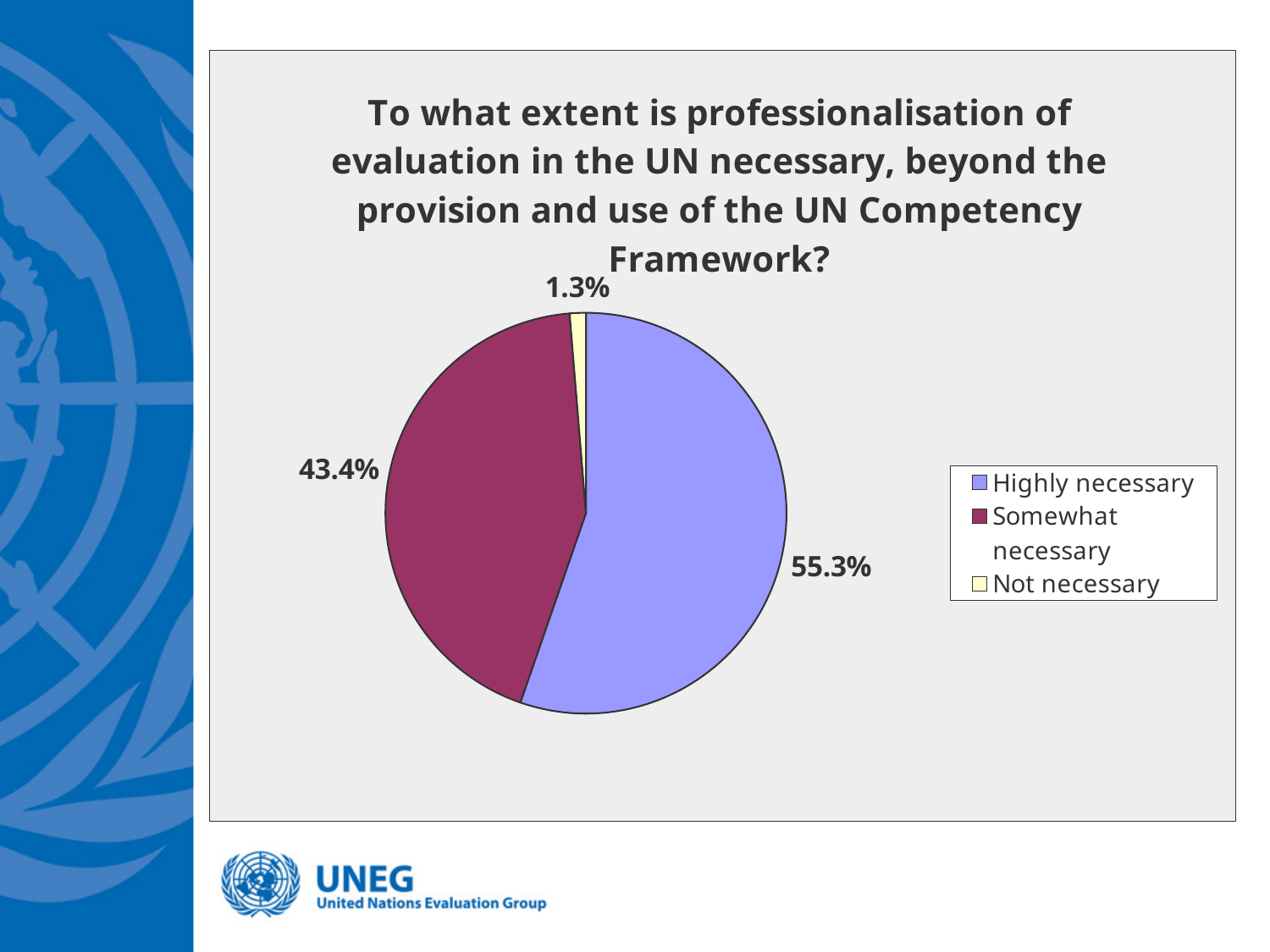
What percentage of respondents said professionalisation of evaluation is not necessary? 1.3% What is the combined share of the 'Highly necessary' and 'Somewhat necessary' slices? 98.7% Which response category has the largest share of the pie? Highly necessary What colour is the 'Somewhat necessary' slice? dark magenta What percentage of respondents said professionalisation of evaluation is highly necessary? 55.3% What kind of chart is shown on the slide? pie chart What percentage of respondents said professionalisation of evaluation is somewhat necessary? 43.4% Which is larger, the 'Somewhat necessary' slice or the 'Not necessary' slice? Somewhat necessary How many categories does the pie chart show? 3 How many entries does the legend list? 3 Which response category has the smallest share of the pie? Not necessary What is the difference in percentage points between the 'Highly necessary' and 'Somewhat necessary' slices? 11.9